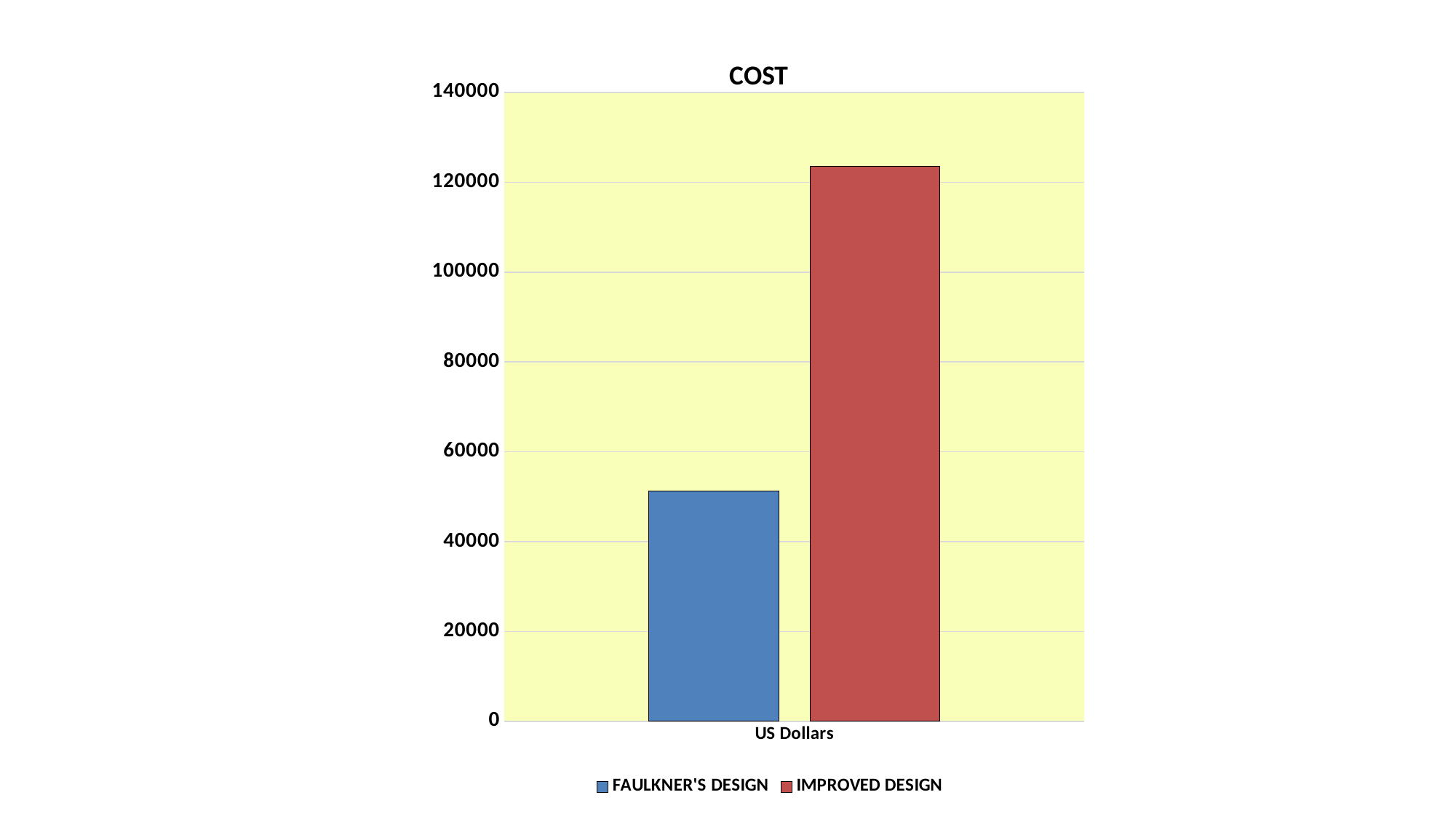
What kind of chart is shown on the slide? bar chart How many series does the legend list? 2 Is the value for FAULKNER'S DESIGN greater or less than 60000? less Which series has the higher cost, FAULKNER'S DESIGN or IMPROVED DESIGN? IMPROVED DESIGN Which series has the lowest cost? FAULKNER'S DESIGN Is the value for IMPROVED DESIGN greater or less than 120000? greater How many bars are plotted in the chart? 2 What is the title of the chart? COST What is the label on the x axis? US Dollars Is the value for IMPROVED DESIGN greater or less than 140000? less